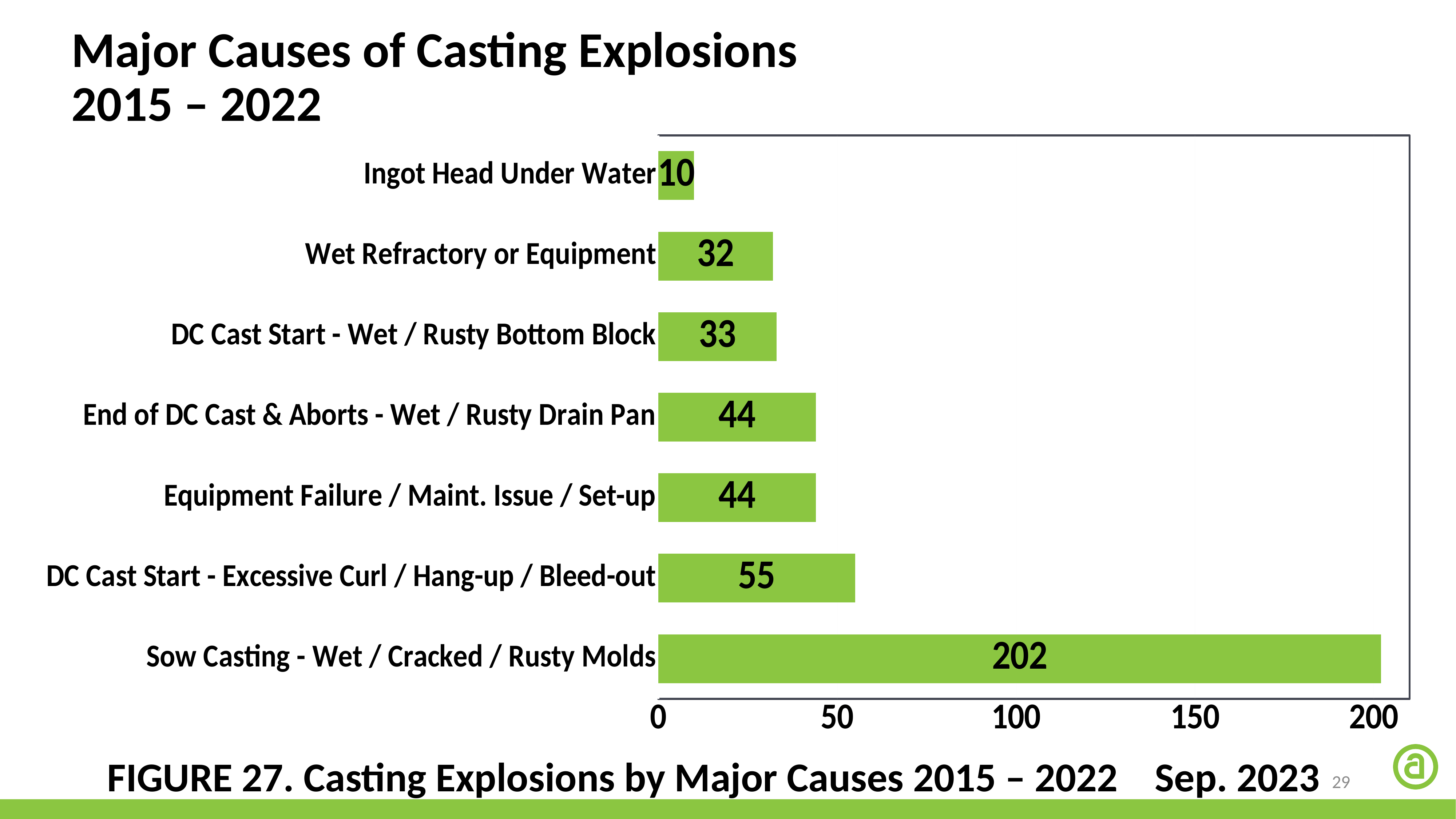
Which cause has the highest value? Sow Casting - Wet / Cracked / Rusty Molds What is the difference between the values for Sow Casting - Wet / Cracked / Rusty Molds and DC Cast Start - Excessive Curl / Hang-up / Bleed-out? 147 What is the value for Ingot Head Under Water? 10 Which is larger, the value for DC Cast Start - Wet / Rusty Bottom Block or the value for Ingot Head Under Water? DC Cast Start - Wet / Rusty Bottom Block What is the value for Sow Casting - Wet / Cracked / Rusty Molds? 202 What is the difference between the values for End of DC Cast & Aborts - Wet / Rusty Drain Pan and Wet Refractory or Equipment? 12 How many causes are shown in the chart? 7 Which cause has the lowest value? Ingot Head Under Water What kind of chart is shown on the slide? Bar chart What is the value for Wet Refractory or Equipment? 32 Is the value for DC Cast Start - Excessive Curl / Hang-up / Bleed-out greater or less than 50? greater What is the value for DC Cast Start - Excessive Curl / Hang-up / Bleed-out? 55